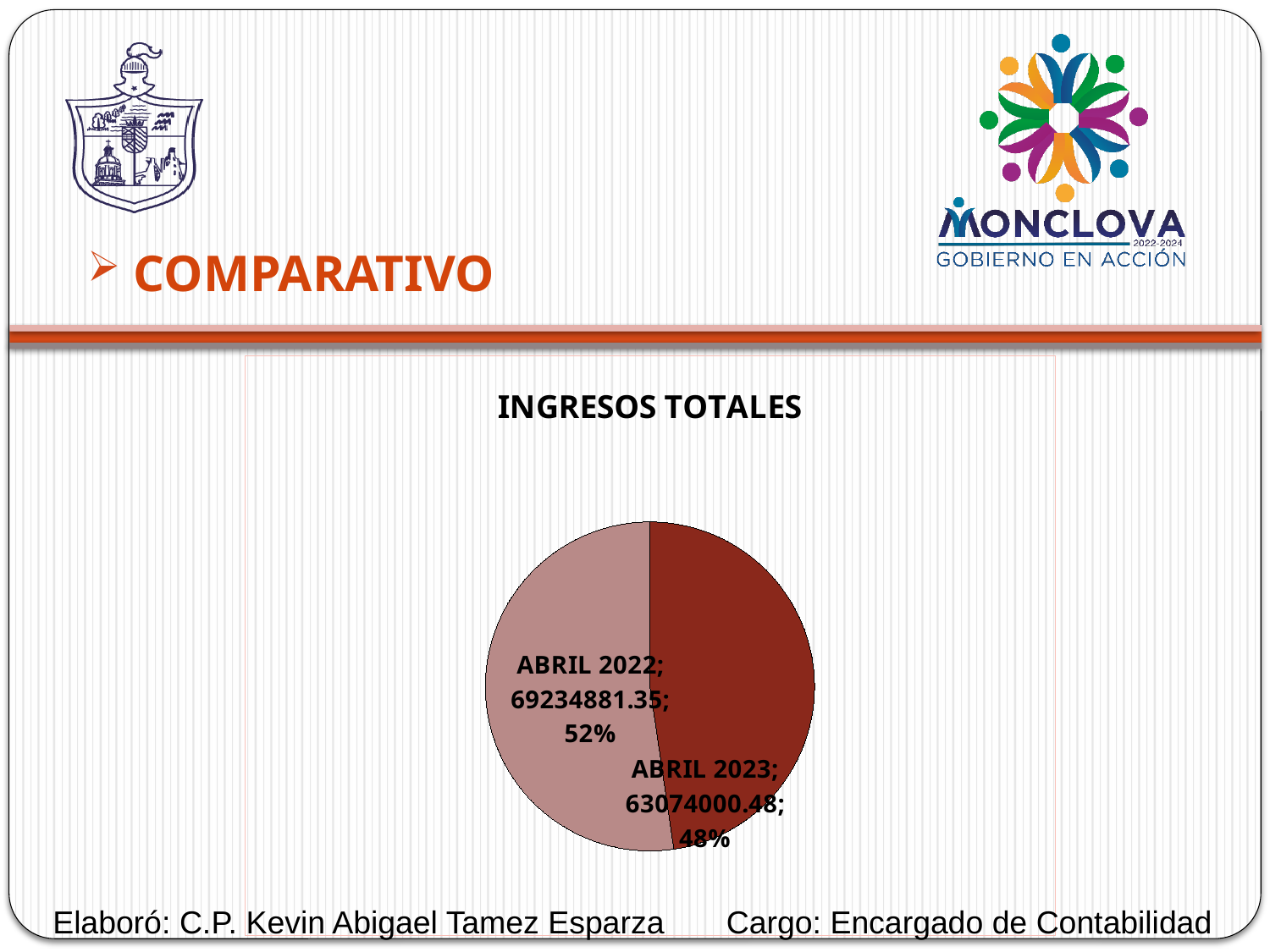
Which slice of the INGRESOS TOTALES pie chart is the smallest? ABRIL 2023 What is the value shown for ABRIL 2023 in the INGRESOS TOTALES pie chart? 63074000.48 How many slices does the INGRESOS TOTALES pie chart have? 2 What is the value shown for ABRIL 2022 in the INGRESOS TOTALES pie chart? 69234881.35 What type of chart is shown under the title INGRESOS TOTALES? pie chart What share of the INGRESOS TOTALES pie does ABRIL 2022 represent? 52% Which slice of the INGRESOS TOTALES pie chart is the largest? ABRIL 2022 In the INGRESOS TOTALES pie chart, which is larger, ABRIL 2022 or ABRIL 2023? ABRIL 2022 What is the difference between the ABRIL 2022 and ABRIL 2023 values in the INGRESOS TOTALES pie chart? 6160880.87 What is the total of the two values shown in the INGRESOS TOTALES pie chart? 132308881.83 What is the title of the chart on the slide? INGRESOS TOTALES What share of the INGRESOS TOTALES pie does ABRIL 2023 represent? 48%